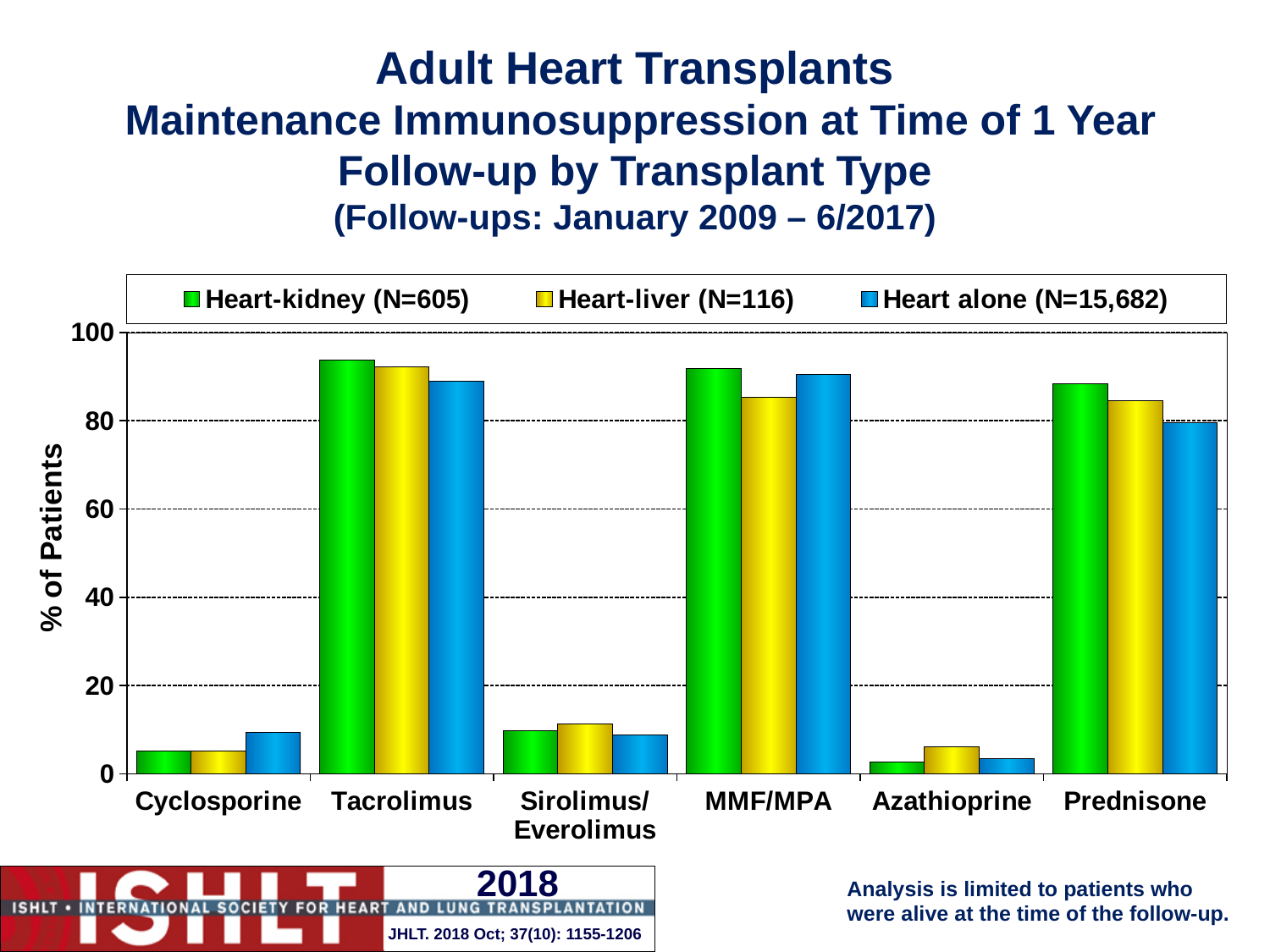
For Cyclosporine, which is larger: the Heart alone value or the Heart-kidney value? Heart alone For Prednisone, which is larger: the Heart-kidney value or the Heart alone value? Heart-kidney For the Heart-liver series, which drug category has the highest value? Tacrolimus How many series does the legend list? 3 Is the Heart-kidney value for Tacrolimus greater or less than 80? greater Is the Heart alone value for Cyclosporine greater or less than 20? less What kind of chart is shown on the slide? bar chart Is the Heart-liver value for MMF/MPA greater or less than 80? greater What is the label of the y axis? % of Patients How many drug categories are shown on the x axis? 6 For the Heart alone series, which drug category has the lowest value? Azathioprine